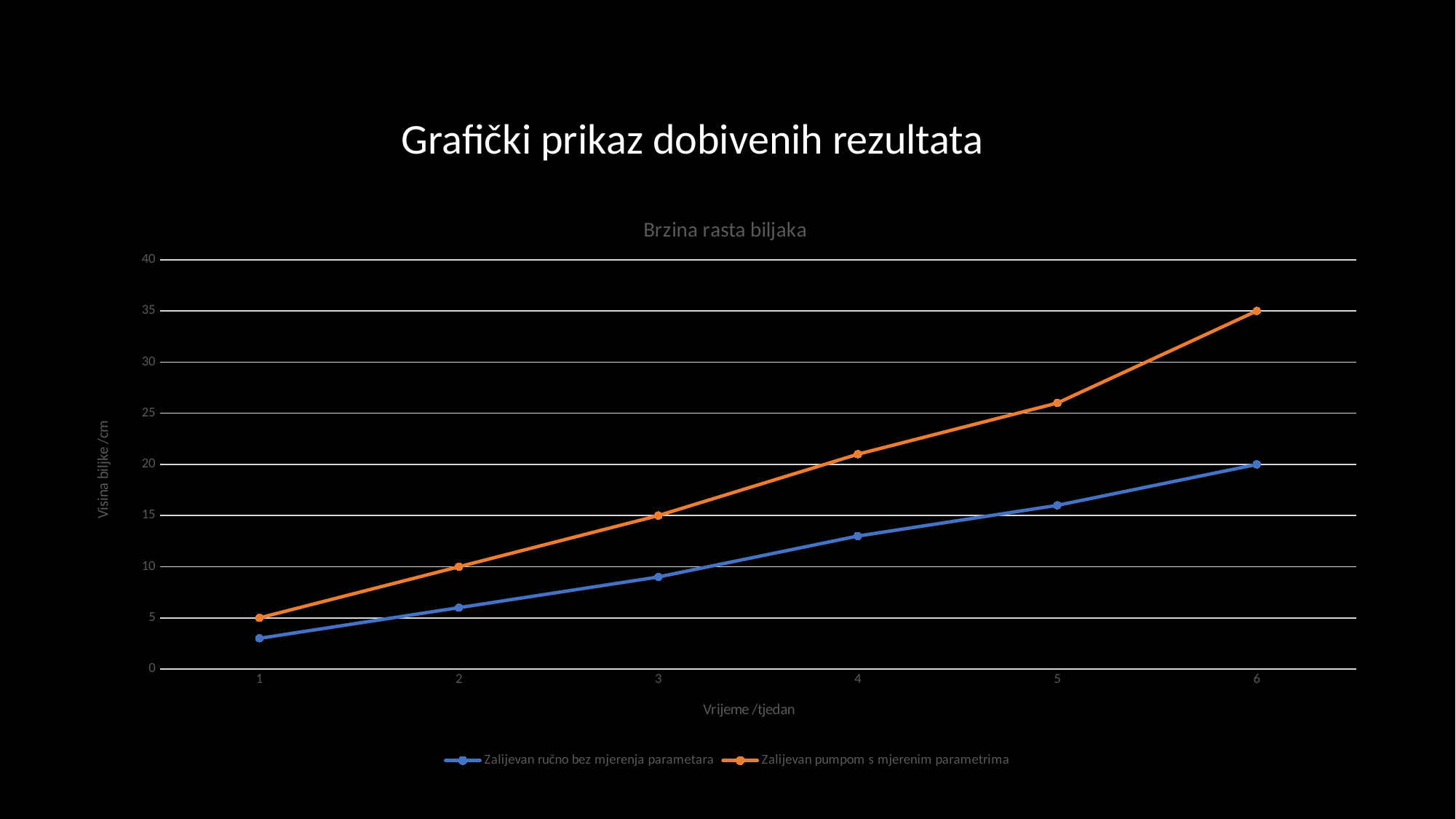
How many points along the x axis (weeks) are plotted for each series? 6 What kind of chart is shown on the slide? line chart Is the value for 'Zalijevan ručno bez mjerenja parametara' at week 4 greater or less than 15? less What is the value for 'Zalijevan pumpom s mjerenim parametrima' at week 6? 35 What is the title of the chart? Brzina rasta biljaka Do the values for 'Zalijevan ručno bez mjerenja parametara' rise or fall from week 1 to week 6? rise How many series does the legend list? 2 Which series has the higher value at week 4? Zalijevan pumpom s mjerenim parametrima What is the value for 'Zalijevan pumpom s mjerenim parametrima' at week 3? 15 What is the difference between the two series at week 6? 15 What is the value for 'Zalijevan ručno bez mjerenja parametara' at week 6? 20 What is the value for 'Zalijevan pumpom s mjerenim parametrima' at week 1? 5